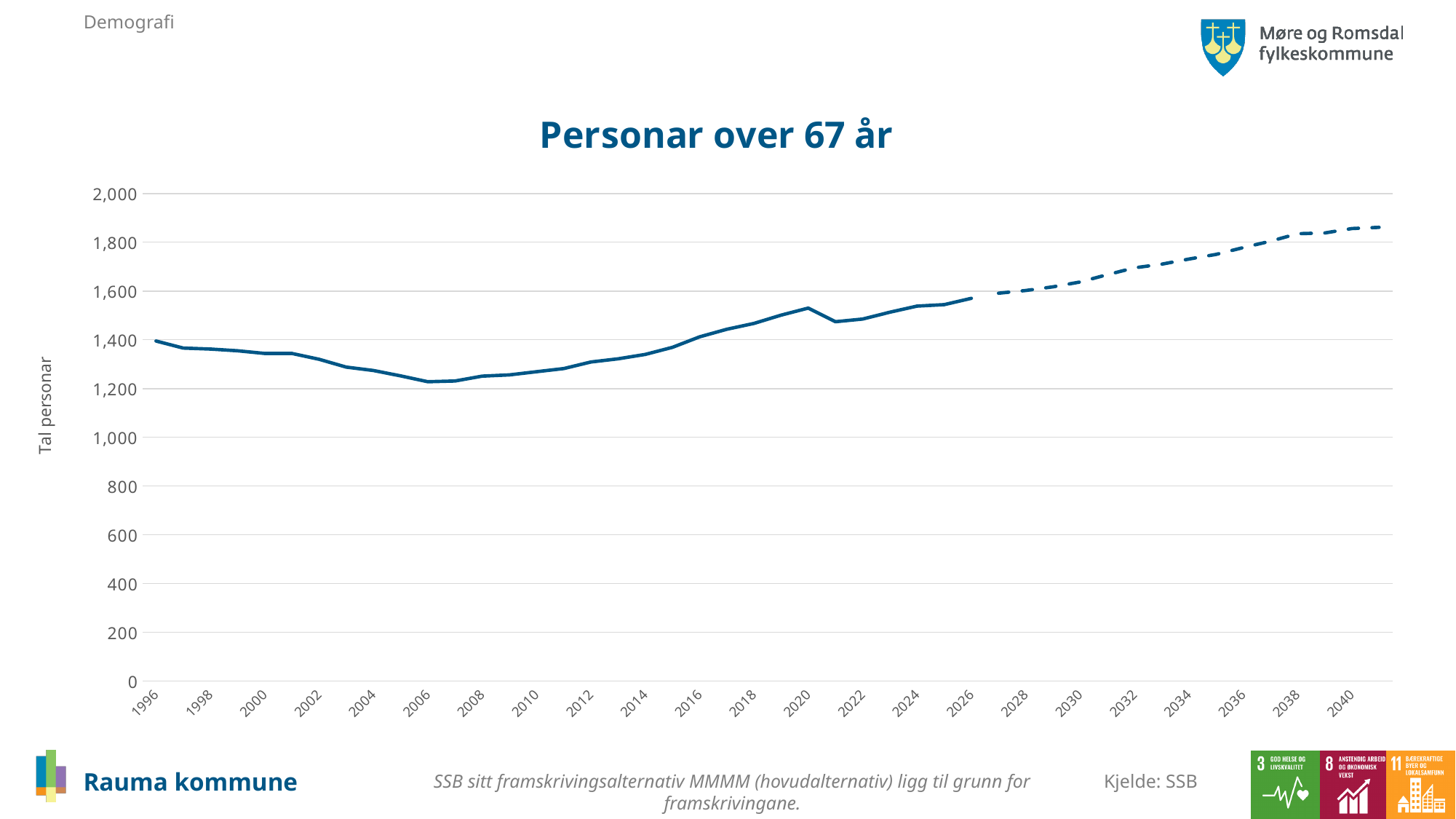
Is the value for 2020 greater or less than 1,400? greater Is the value for 2006 greater or less than 1,400? less What is the title of the chart? Personar over 67 år Does the line rise or fall between 2006 and 2040? rise Is the value for 2030 greater or less than 1,600? greater What kind of chart is shown on the slide? line chart Which is larger, the value for 2020 or the value for 2006? 2020 What is the label on the vertical axis of the chart? Tal personar Around which year does the line reach its lowest value? 2006